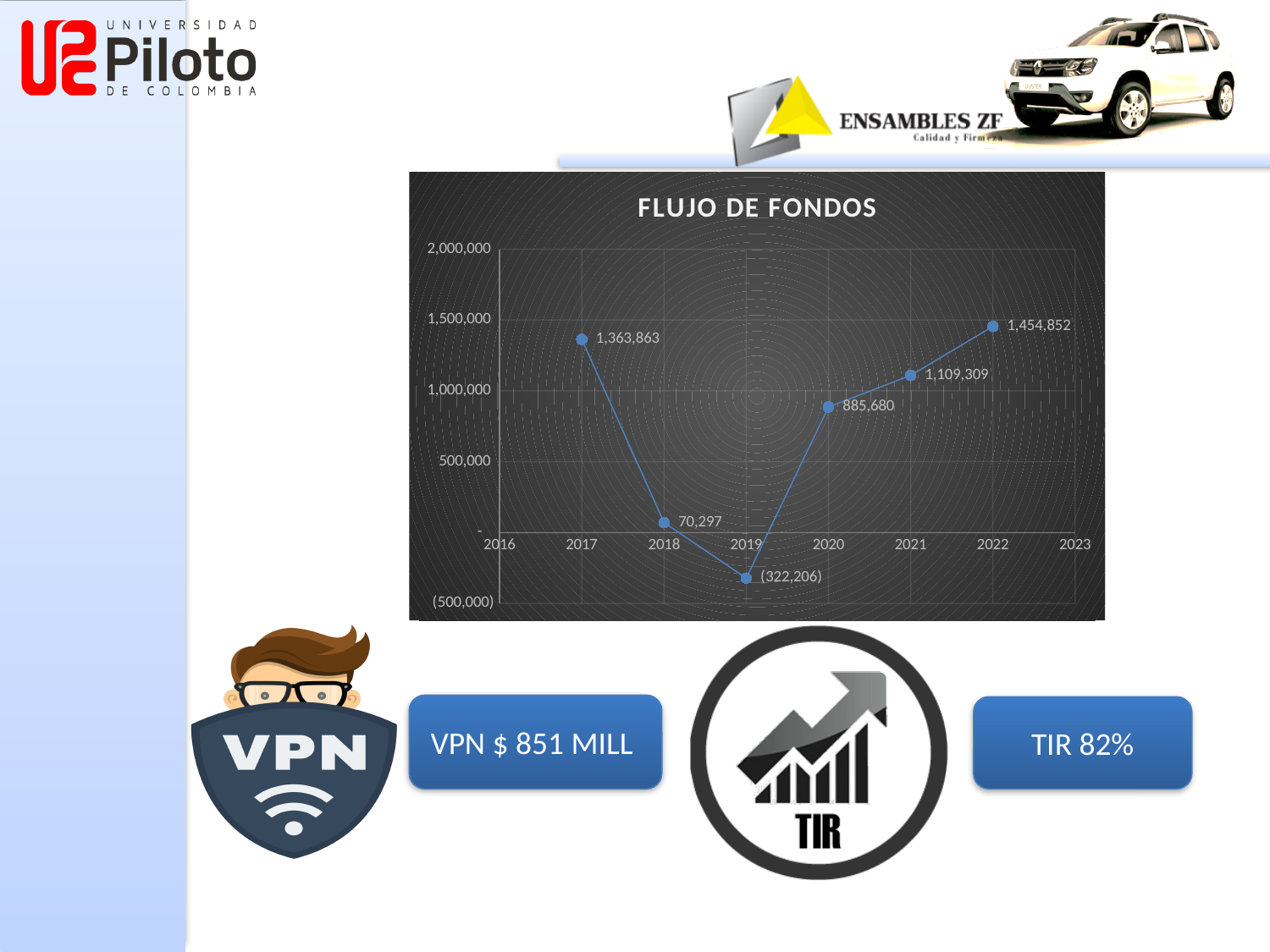
What kind of chart is the FLUJO DE FONDOS chart? Line chart How many data points are plotted in the FLUJO DE FONDOS chart? 6 In the FLUJO DE FONDOS chart, which is larger: the value for 2018 or the value for 2020? 2020 Which year has the highest value in the FLUJO DE FONDOS chart? 2022 What is the difference between the 2021 value and the 2020 value in the FLUJO DE FONDOS chart? 223,629 Is the value for 2021 in the FLUJO DE FONDOS chart greater or less than 1,000,000? greater What is the value plotted for 2019 in the FLUJO DE FONDOS chart? (322,206) What is the value plotted for 2022 in the FLUJO DE FONDOS chart? 1,454,852 Which year has the lowest value in the FLUJO DE FONDOS chart? 2019 What is the difference between the 2022 value and the 2017 value in the FLUJO DE FONDOS chart? 90,989 What is the value plotted for 2020 in the FLUJO DE FONDOS chart? 885,680 What is the value plotted for 2017 in the FLUJO DE FONDOS chart? 1,363,863